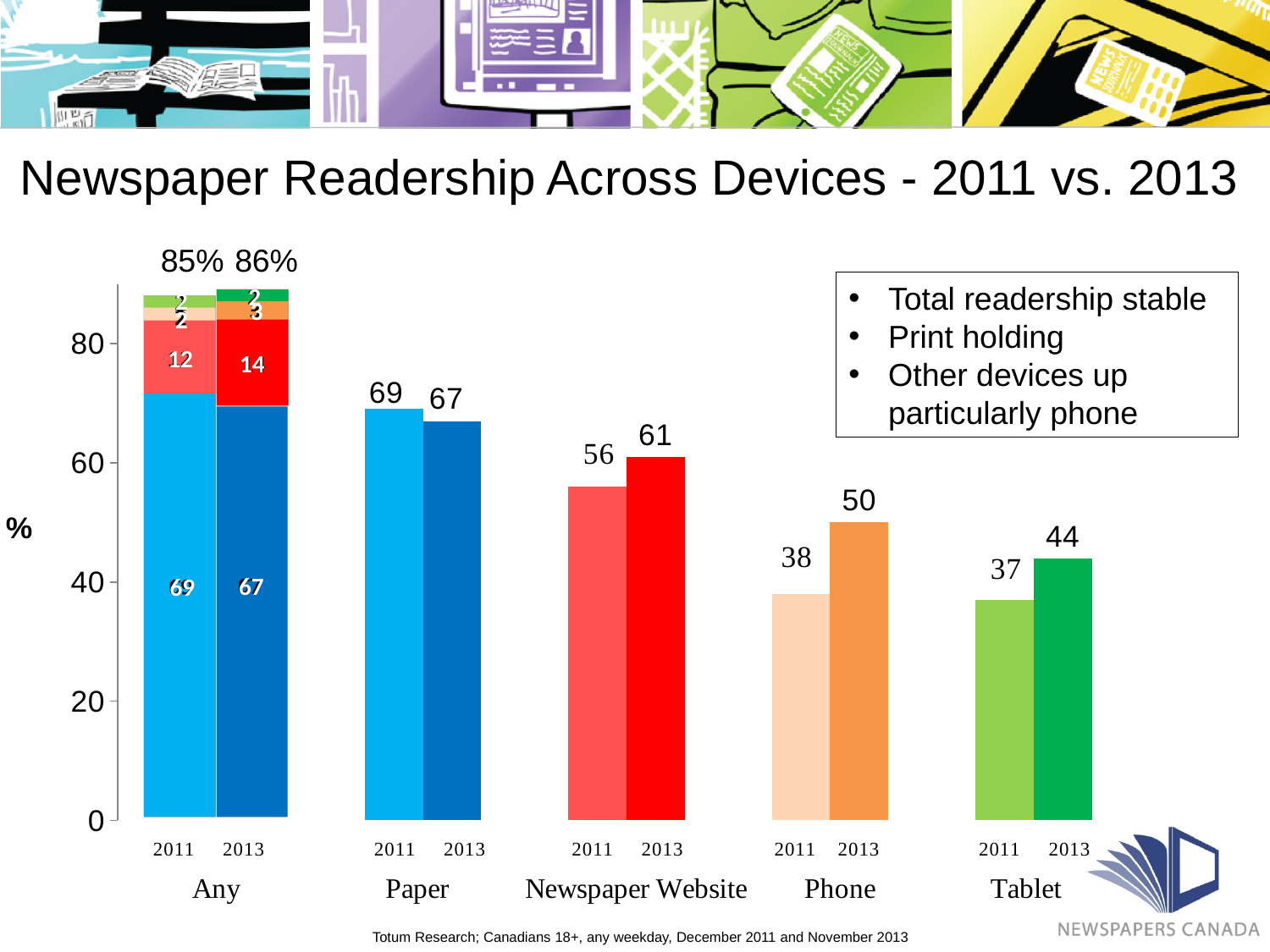
Among the non-stacked device categories (Paper, Newspaper Website, Phone, Tablet), which has the lowest 2011 value? Tablet What is the total shown above the 2013 stacked bar for Any? 86% What is the value for Tablet in 2011? 37 What kind of chart is shown on the slide? Bar chart What is the difference between the 2013 and 2011 values for Phone? 12 How many device categories are shown along the x axis? 5 What is the value for Newspaper Website in 2013? 61 What is the title of the chart? Newspaper Readership Across Devices - 2011 vs. 2013 What is the value for Paper in 2011? 69 Which is larger, the 2011 value for Newspaper Website or the 2013 value for Phone? 2011 Newspaper Website Among the non-stacked device categories (Paper, Newspaper Website, Phone, Tablet), which has the highest 2013 value? Paper What is the value for Phone in 2013? 50